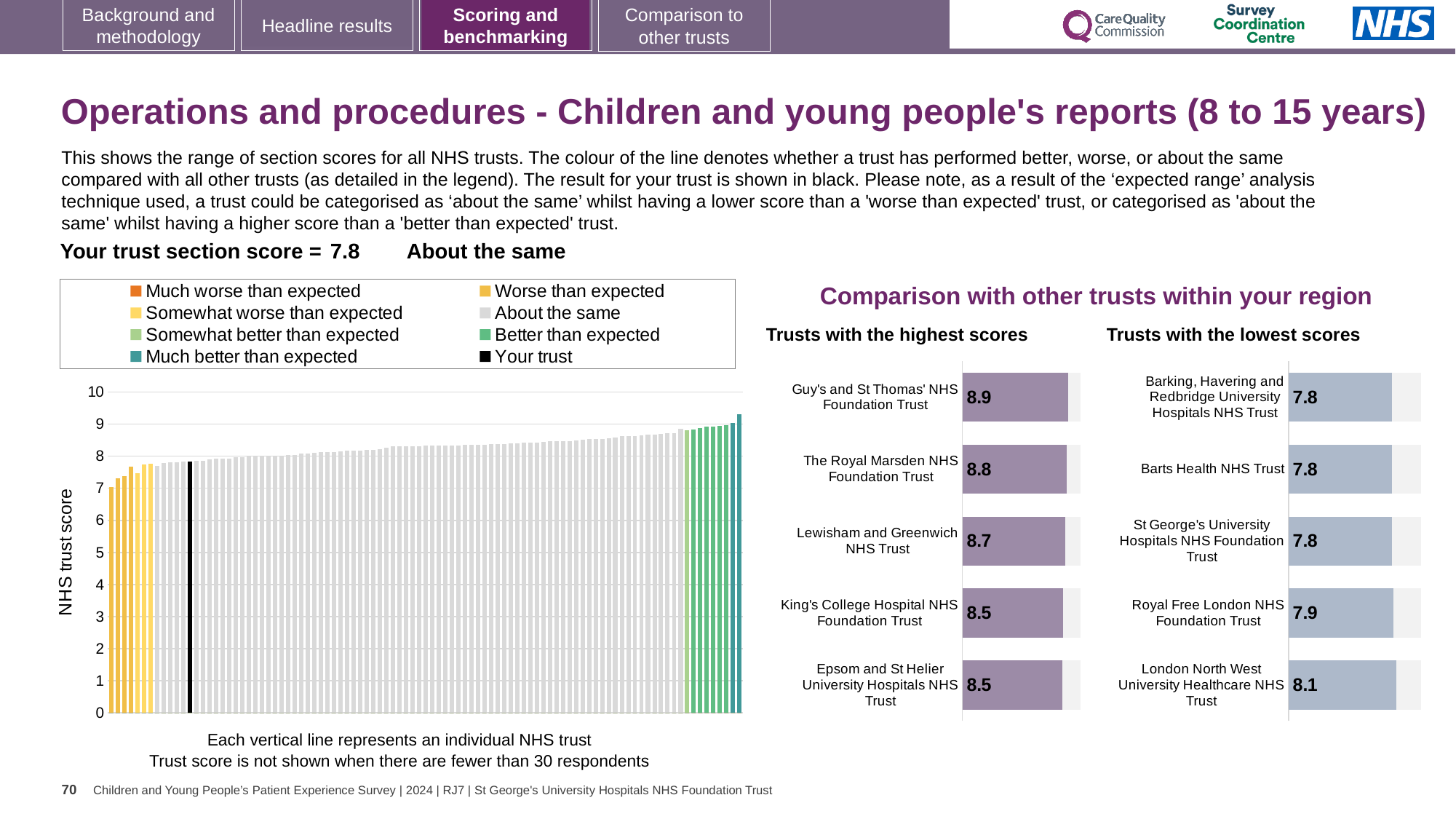
In the 'Trusts with the lowest scores' chart, which trust has the highest score? London North West University Healthcare NHS Trust In the main 'NHS trust score' chart on the left, is the value of the leftmost bar greater or less than 8? less In the 'Trusts with the lowest scores' chart, what is the difference between the scores of London North West University Healthcare NHS Trust and Barts Health NHS Trust? 0.3 In the 'Trusts with the highest scores' chart, which has the larger score: The Royal Marsden NHS Foundation Trust or King's College Hospital NHS Foundation Trust? The Royal Marsden NHS Foundation Trust In the main 'NHS trust score' chart on the left, do the bar values rise or fall from left to right? rise In the 'Trusts with the highest scores' chart, what is the score for Guy's and St Thomas' NHS Foundation Trust? 8.9 How many trusts are shown in the 'Trusts with the lowest scores' chart? 5 In the 'Trusts with the lowest scores' chart, what is the score for Royal Free London NHS Foundation Trust? 7.9 In the 'Trusts with the highest scores' chart, what is the difference between the scores of Guy's and St Thomas' NHS Foundation Trust and Epsom and St Helier University Hospitals NHS Trust? 0.4 What kind of chart is the main 'NHS trust score' chart on the left? bar chart In the 'Trusts with the highest scores' chart, which trust has the highest score? Guy's and St Thomas' NHS Foundation Trust How many entries does the legend above the main 'NHS trust score' chart list? 8